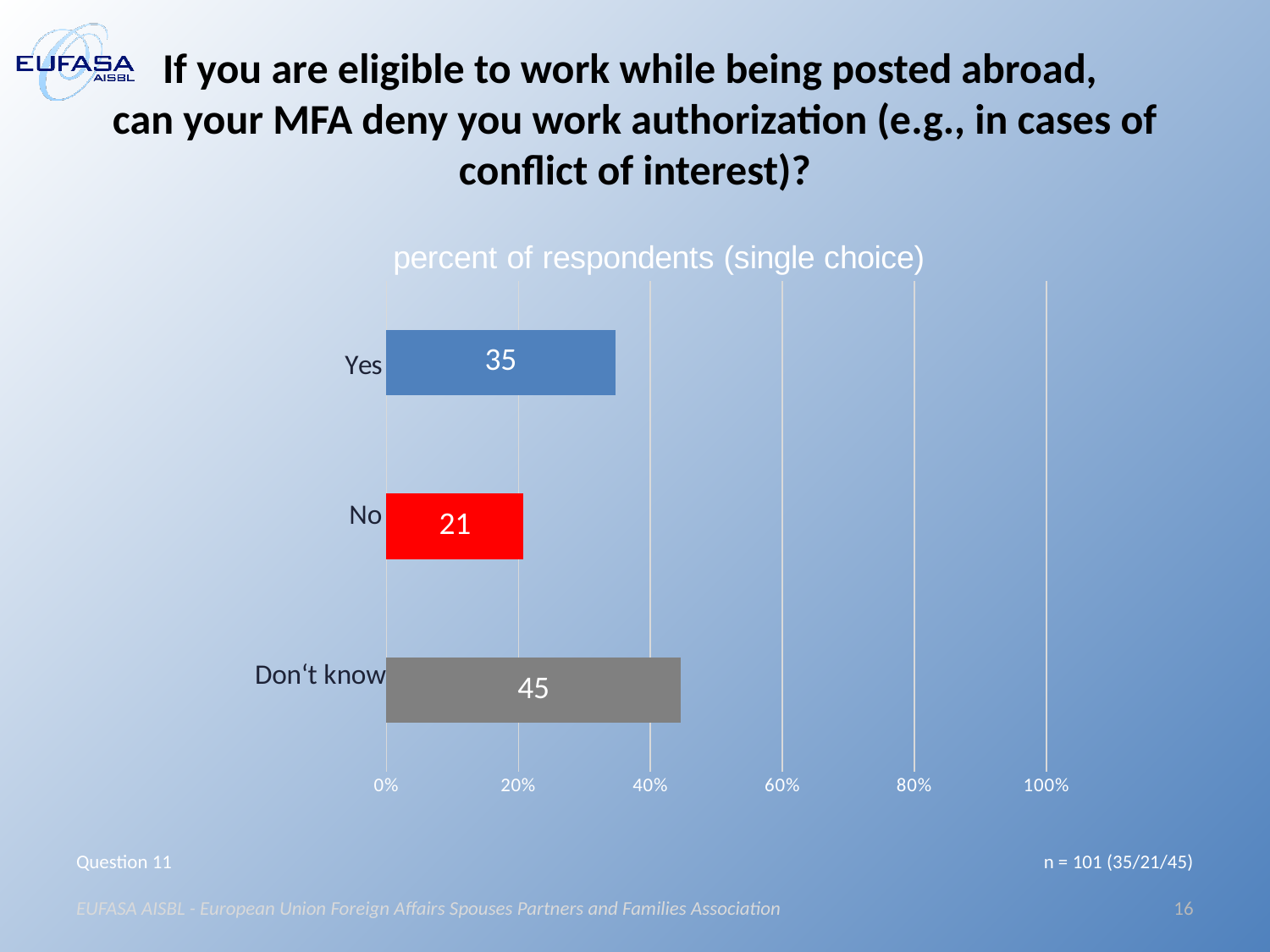
Is the value for "Don't know" greater or less than 40%? greater How many categories are shown in the chart? 3 What is the difference between the values for "Yes" and "No"? 14 What is the value for "Yes"? 35 What is the difference between the values for "Don't know" and "Yes"? 10 What is the title of the chart? percent of respondents (single choice) Which is larger, the value for "Yes" or the value for "No"? Yes What is the value for "Don't know"? 45 Which category has the highest value? Don't know Which category has the lowest value? No What kind of chart is shown on the slide? bar chart What is the value for "No"? 21